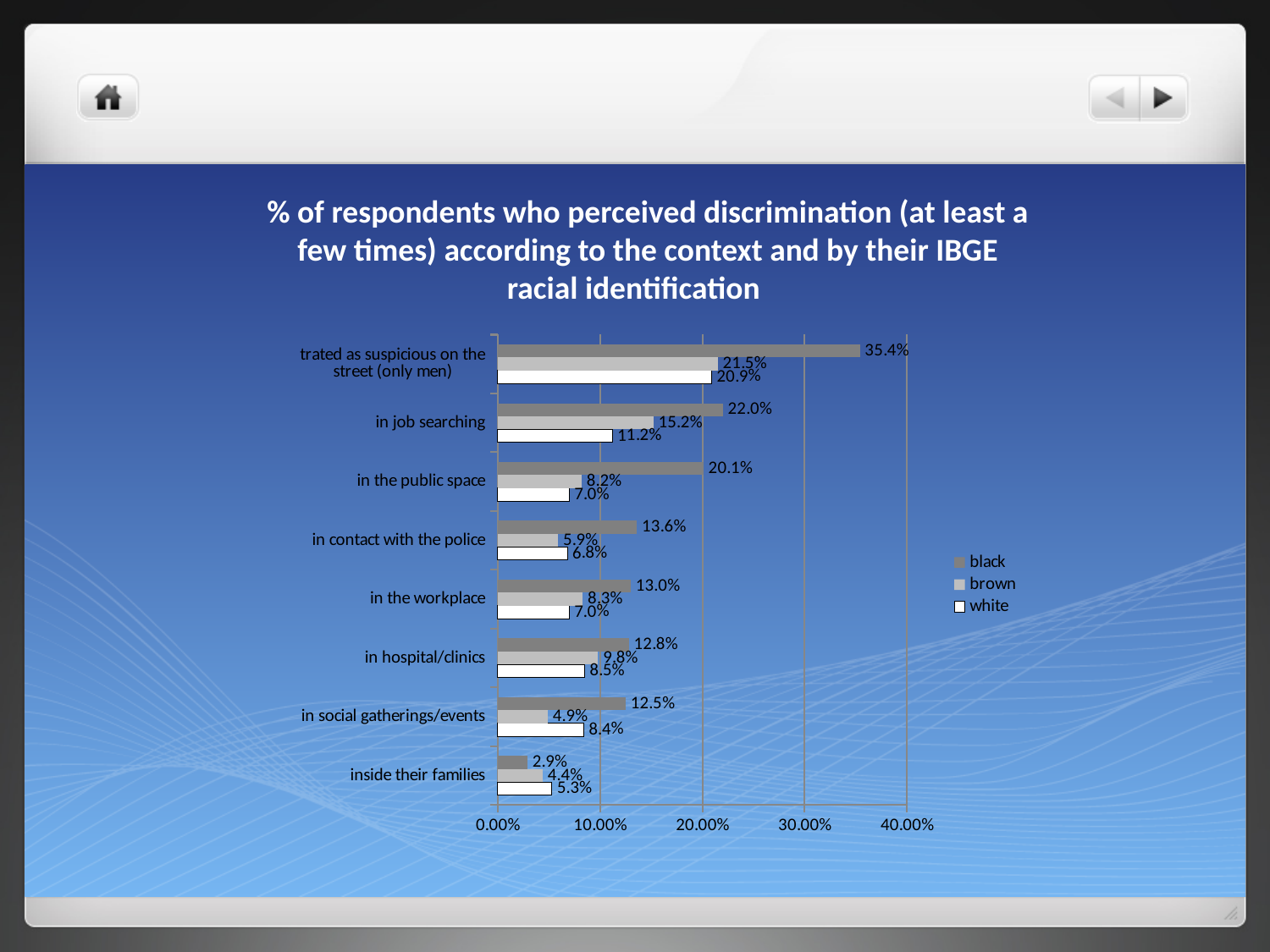
What is the value for the white series in the 'in hospital/clinics' category? 8.5% What is the difference between the black and white values in the 'in the public space' category? 13.1% In the 'inside their families' category, which is larger: the black value or the white value? white What is the value for the black series in the 'in job searching' category? 22.0% Which category has the lowest value for the white series? inside their families Which category has the highest value for the black series? trated as suspicious on the street (only men) What is the value for the brown series in the 'in contact with the police' category? 5.9% Which series is shown in white in the legend? white What type of chart is shown on the slide? bar chart How many context categories are plotted on the chart? 8 Is the value for the black series in the 'trated as suspicious on the street (only men)' category greater or less than 30.00%? greater How many series does the legend list? 3